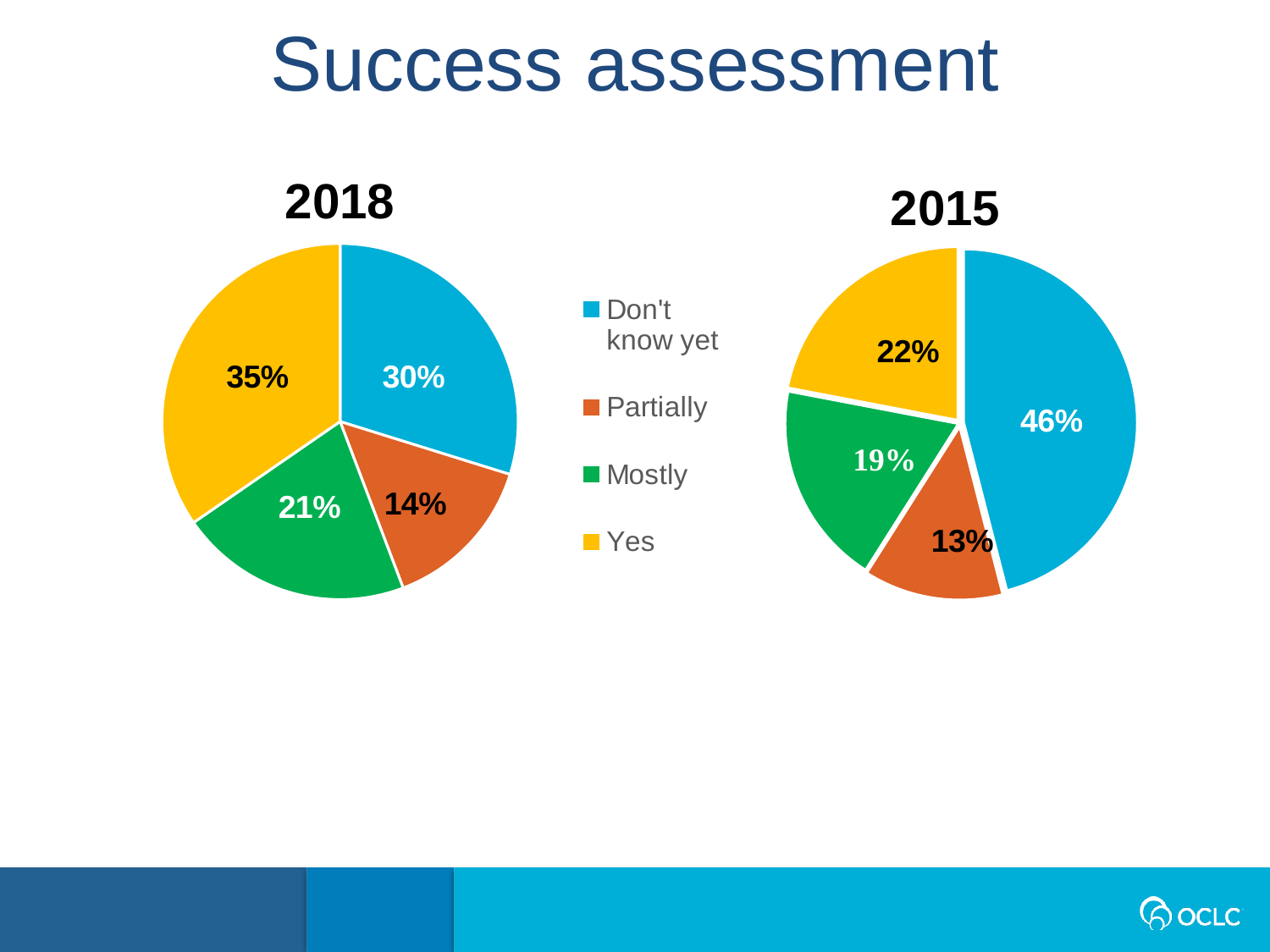
In the 2018 pie chart, which category has the largest slice? Yes Which is larger: the "Yes" share in 2018 or the "Yes" share in 2015? 2018 How many slices does the 2015 pie chart have? 4 In the 2018 pie chart, what share is labelled for "Yes"? 35% In the 2015 pie chart, what share is labelled for "Don't know yet"? 46% What is the difference between the "Don't know yet" share in 2015 and in 2018? 16% In the 2018 pie chart, which category has the smallest slice? Partially What type of chart is used for the 2018 data? Pie chart In the 2015 pie chart, which category has the smallest slice? Partially Which colour represents "Mostly" in the legend? Green In the 2015 pie chart, what share is labelled for "Mostly"? 19% In the 2018 pie chart, what share is labelled for "Partially"? 14%